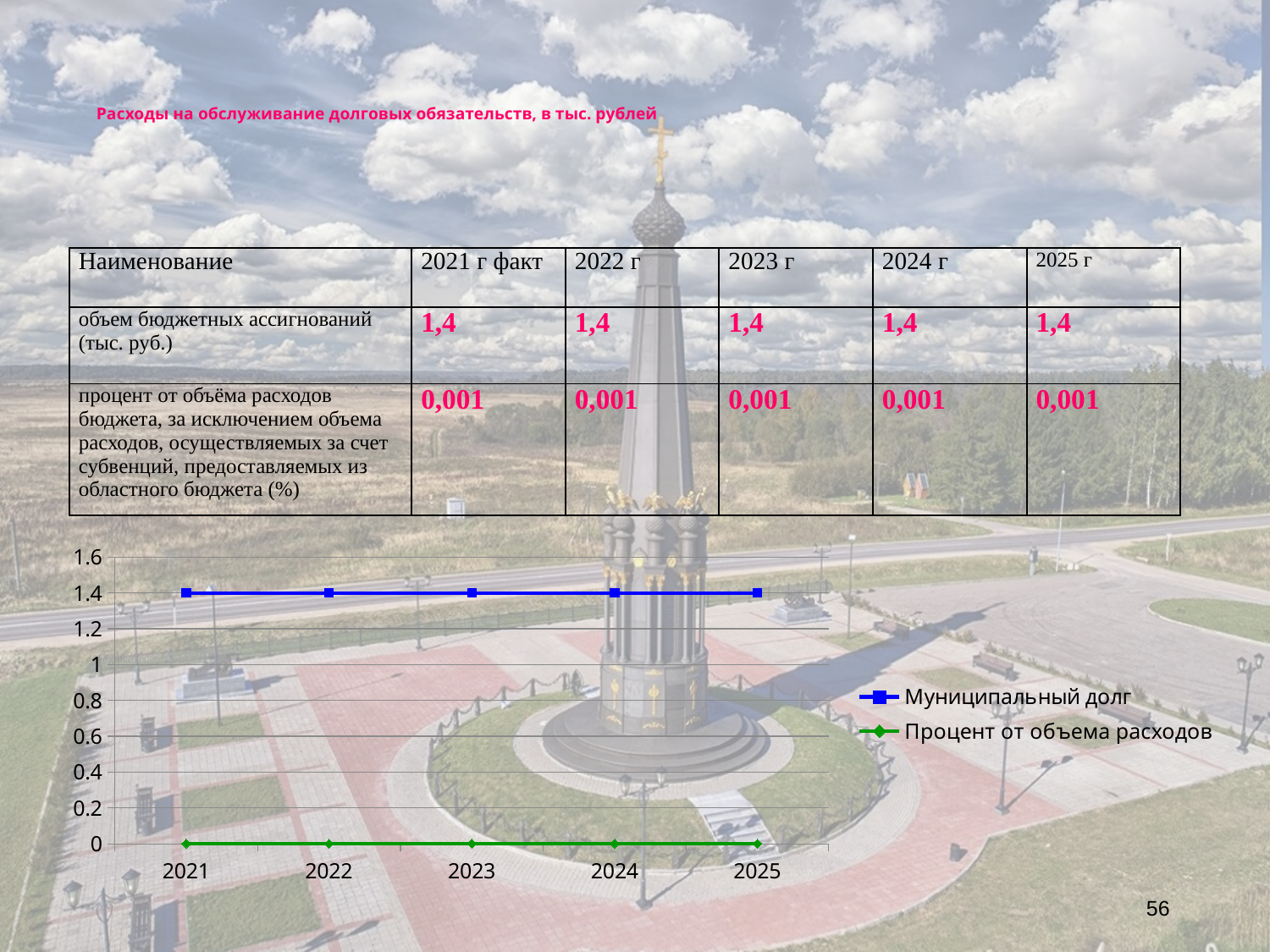
How many series does the chart legend list? 2 What is the highest tick value shown on the chart's y axis? 1.6 What colour is the Муниципальный долг line in the chart? blue What is the value of Муниципальный долг in 2023 on the chart? 1.4 What is the value of Муниципальный долг in 2021 on the chart? 1.4 How many years are shown along the x axis of the chart? 5 Is the value for Муниципальный долг in 2025 greater or less than 1? greater What kind of chart is shown on the slide? line chart Which series is higher in 2024, Муниципальный долг or Процент от объема расходов? Муниципальный долг Is the value for Процент от объема расходов in 2022 greater or less than 0.2? less Does the Муниципальный долг line rise, fall or stay flat from 2021 to 2025? stays flat